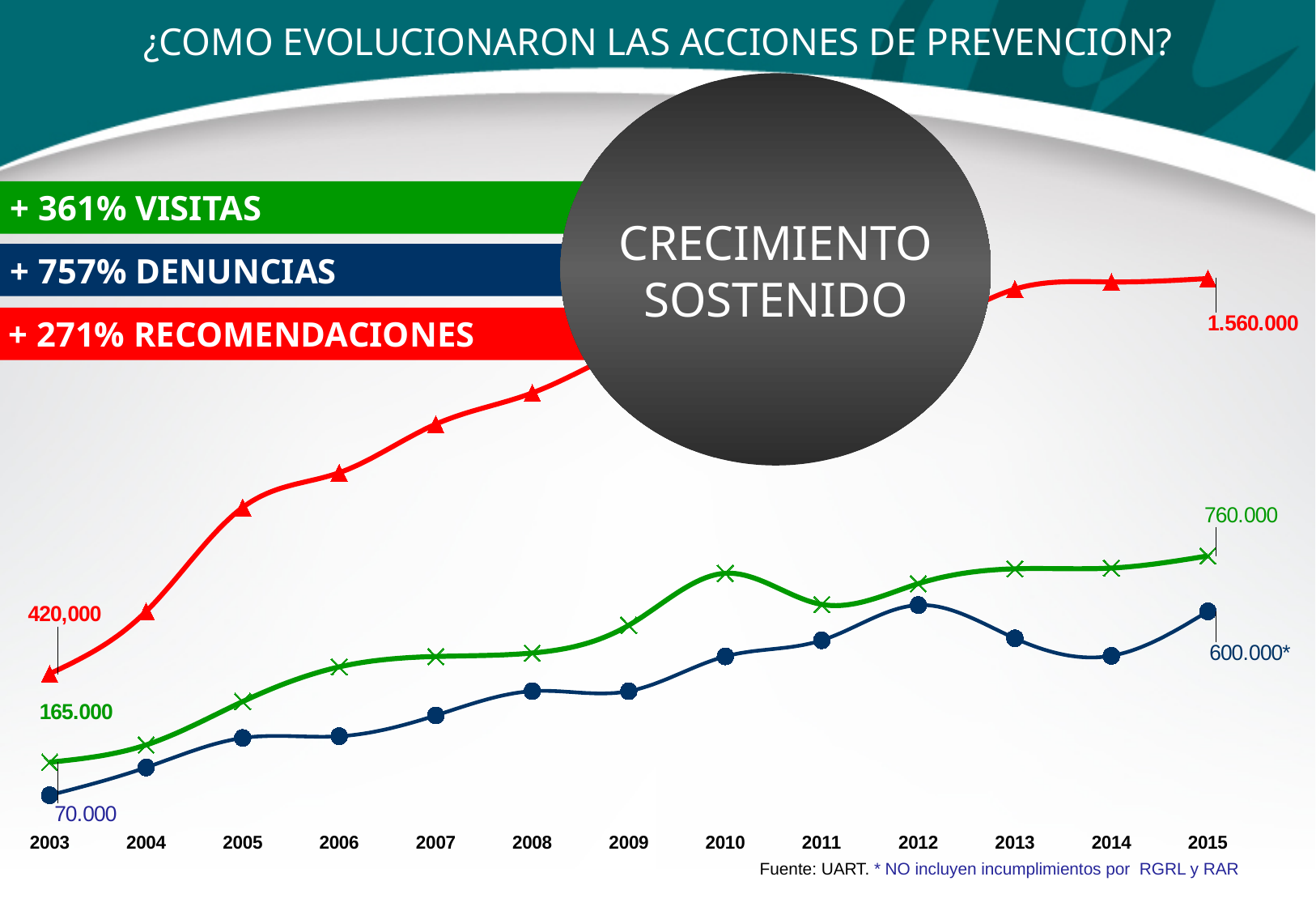
What value is labelled for the red line (Recomendaciones) in 2003? 420,000 What value is labelled for the blue line (Denuncias) in 2003? 70.000 What is the last year shown on the x axis? 2015 What value is labelled for the blue line (Denuncias) in 2015? 600.000* What value is labelled for the green line (Visitas) in 2003? 165.000 What value is labelled for the red line (Recomendaciones) in 2015? 1.560.000 Does the red line (Recomendaciones) rise or fall from 2003 to 2015? rise What type of chart is shown on the slide? line chart Which of the three lines has the highest value in 2015? the red line (Recomendaciones) What is the first year shown on the x axis? 2003 How many years are shown along the x axis of the chart? 13 What value is labelled for the green line (Visitas) in 2015? 760.000